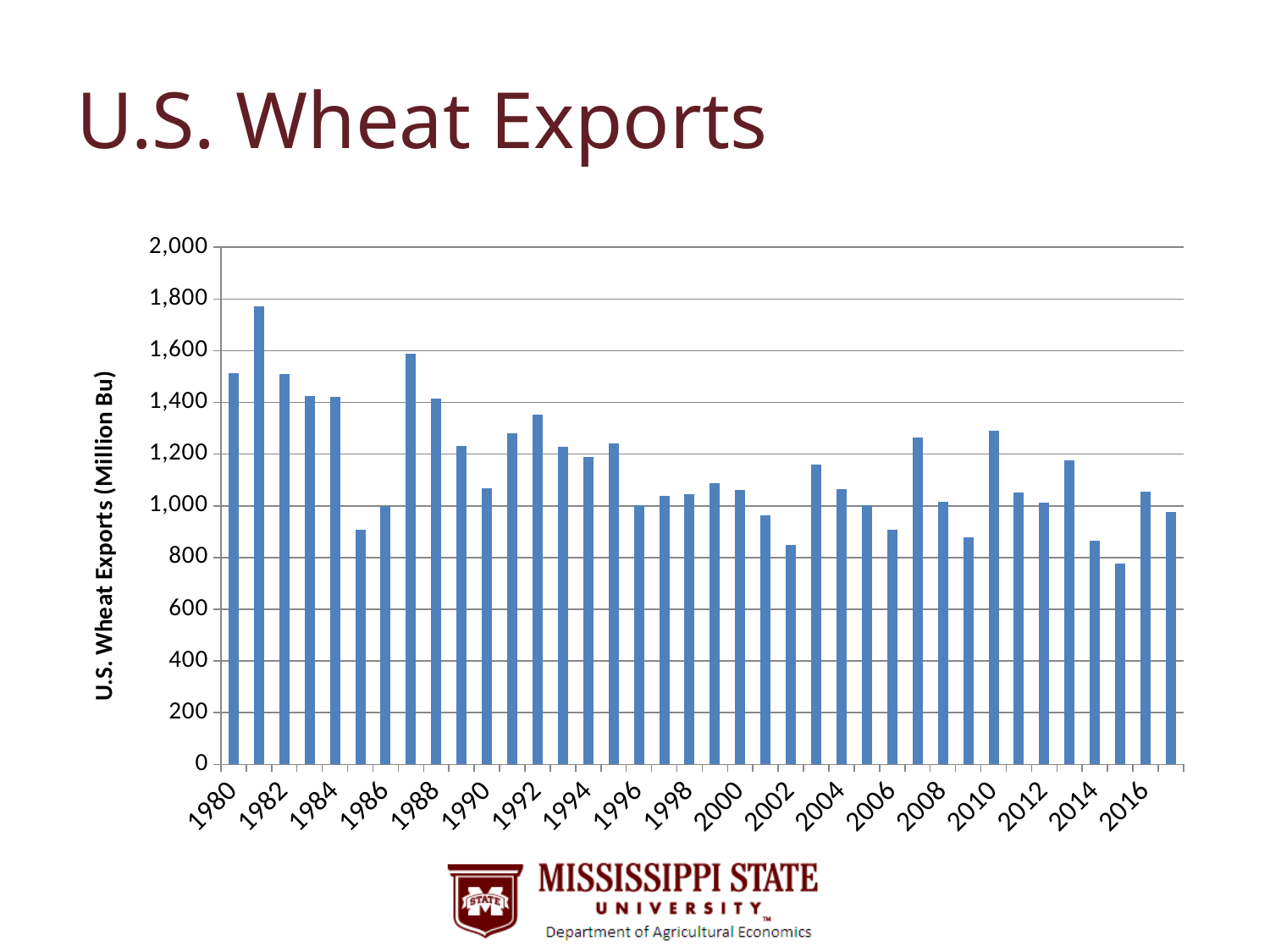
Is the value for 2002 greater or less than 1,000? less Which year has the highest U.S. wheat exports in the chart? 1981 Which year has higher U.S. wheat exports, 2010 or 2015? 2010 Is the value for 2015 greater or less than 800? less Is the value for 1981 greater or less than 1,600? greater Which year has higher U.S. wheat exports, 1988 or 1990? 1988 What kind of chart is shown on the slide? bar chart Overall, do U.S. wheat exports rise or fall from 1980 to the end of the chart? fall Which year has the lowest U.S. wheat exports in the chart? 2015 What is the title of the chart? U.S. Wheat Exports What is the label on the vertical axis of the chart? U.S. Wheat Exports (Million Bu)